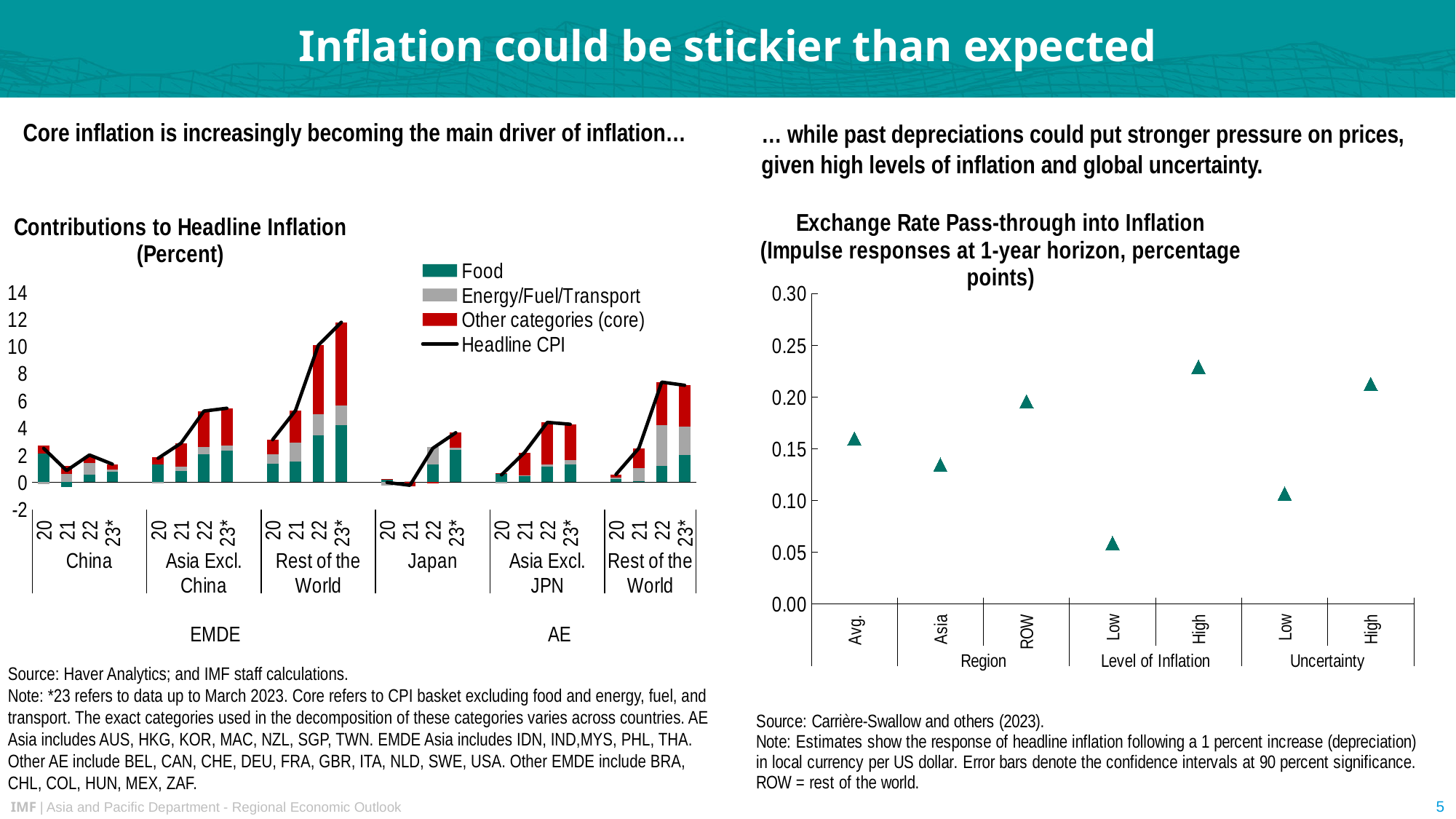
On the left chart, Contributions to Headline Inflation, is the Headline CPI for Rest of the World (EMDE) in 23* greater or less than 10? greater On the right chart, Exchange Rate Pass-through into Inflation, is the value for Low under Level of Inflation greater or less than 0.10? less On the left chart, Contributions to Headline Inflation, is the Headline CPI for Japan in 20 greater or less than 2? less On the right chart, Exchange Rate Pass-through into Inflation, which category has the lowest value? Low (Level of Inflation) On the left chart, Contributions to Headline Inflation, what kind of chart is it? Stacked bar chart with a line On the left chart, Contributions to Headline Inflation, how many entries does the legend list? 4 On the left chart, Contributions to Headline Inflation, which country group and year has the highest Headline CPI? Rest of the World (EMDE), 23* On the right chart, Exchange Rate Pass-through into Inflation, which is larger, the value for Asia or the value for ROW? ROW On the right chart, Exchange Rate Pass-through into Inflation, how many data points are plotted? 7 On the left chart, Contributions to Headline Inflation, which legend entry is shown in red? Other categories (core)